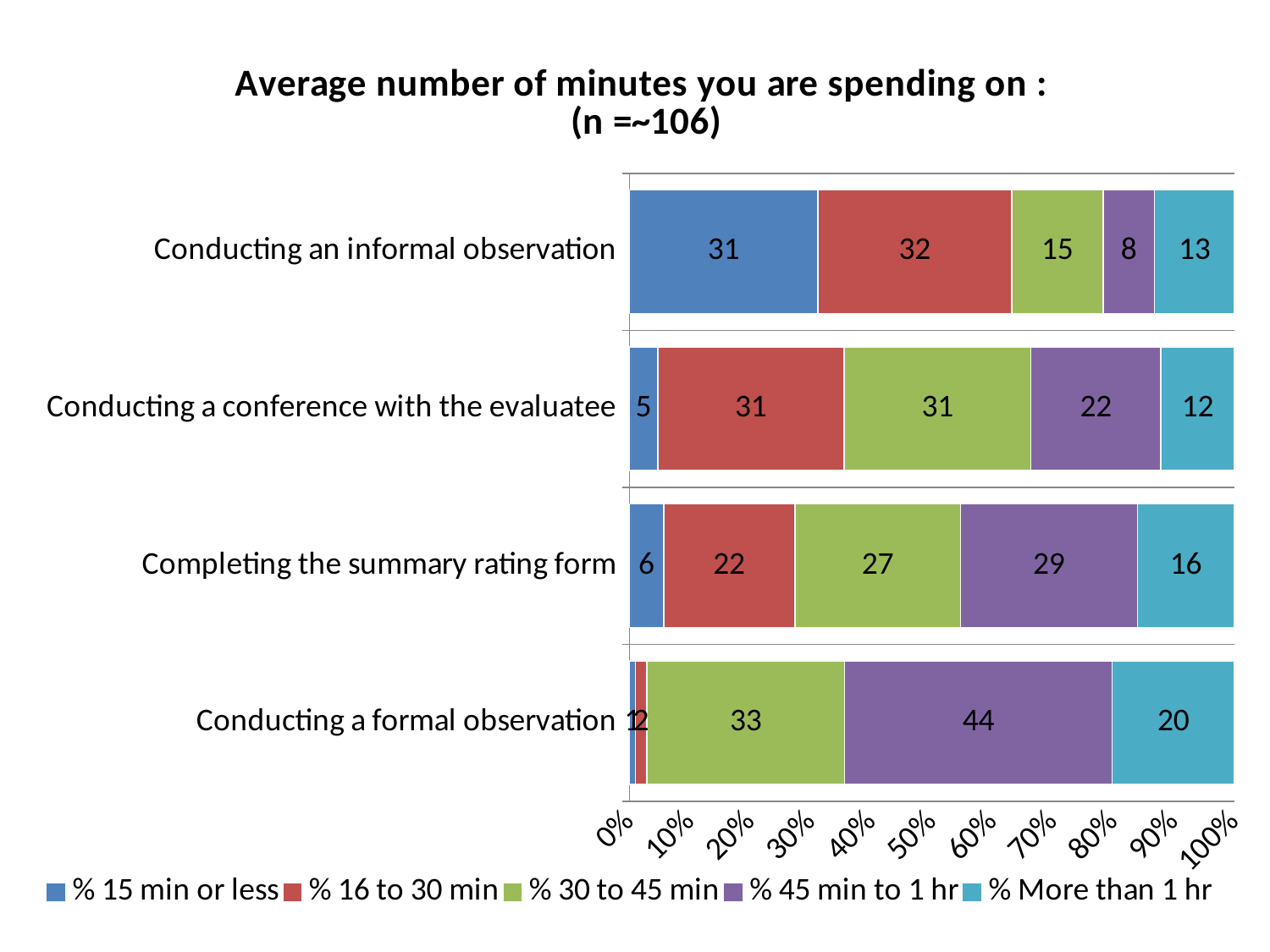
What is the value of '% 45 min to 1 hr' for 'Conducting a formal observation'? 44 What is the value of '% 15 min or less' for 'Conducting a conference with the evaluatee'? 5 What is the title of the chart? Average number of minutes you are spending on : (n =~106) How many categories are plotted on the chart? 4 What is the value of '% More than 1 hr' for 'Completing the summary rating form'? 16 What is the value of '% 16 to 30 min' for 'Conducting an informal observation'? 32 How many series does the legend list? 5 Which category has the highest value for '% 15 min or less'? Conducting an informal observation Which category has the lowest value for '% 45 min to 1 hr'? Conducting an informal observation What is the difference between the '% 30 to 45 min' values for 'Conducting a formal observation' and 'Conducting an informal observation'? 18 Which is larger: '% More than 1 hr' for 'Conducting a formal observation' or for 'Conducting a conference with the evaluatee'? Conducting a formal observation What kind of chart is shown on the slide? Stacked bar chart